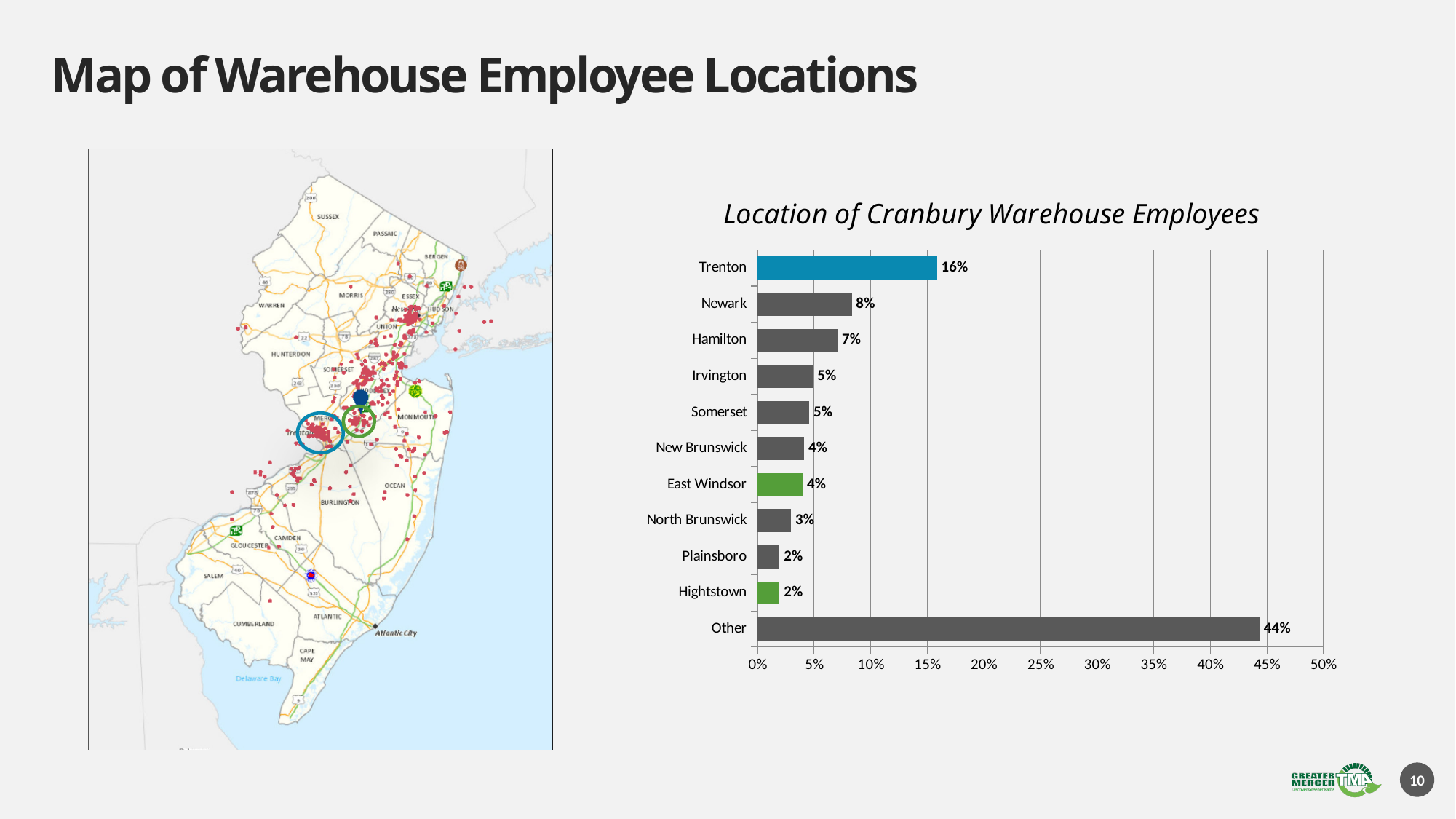
What is the difference between the values for Other and Trenton in the Location of Cranbury Warehouse Employees chart? 28% Which is larger in the Location of Cranbury Warehouse Employees chart, Newark or Hamilton? Newark What is the value for Hamilton in the Location of Cranbury Warehouse Employees chart? 7% What is the difference between the values for Trenton and Newark in the Location of Cranbury Warehouse Employees chart? 8% What kind of chart is the Location of Cranbury Warehouse Employees chart? Bar chart Which category has the highest value in the Location of Cranbury Warehouse Employees chart? Other What is the value for North Brunswick in the Location of Cranbury Warehouse Employees chart? 3% How many categories are shown in the Location of Cranbury Warehouse Employees chart? 11 What is the value for Trenton in the Location of Cranbury Warehouse Employees chart? 16% Which two categories in the Location of Cranbury Warehouse Employees chart have green bars? East Windsor and Hightstown Is the value for Other in the Location of Cranbury Warehouse Employees chart greater or less than 40%? greater Excluding Other, which named location has the highest share in the Location of Cranbury Warehouse Employees chart? Trenton